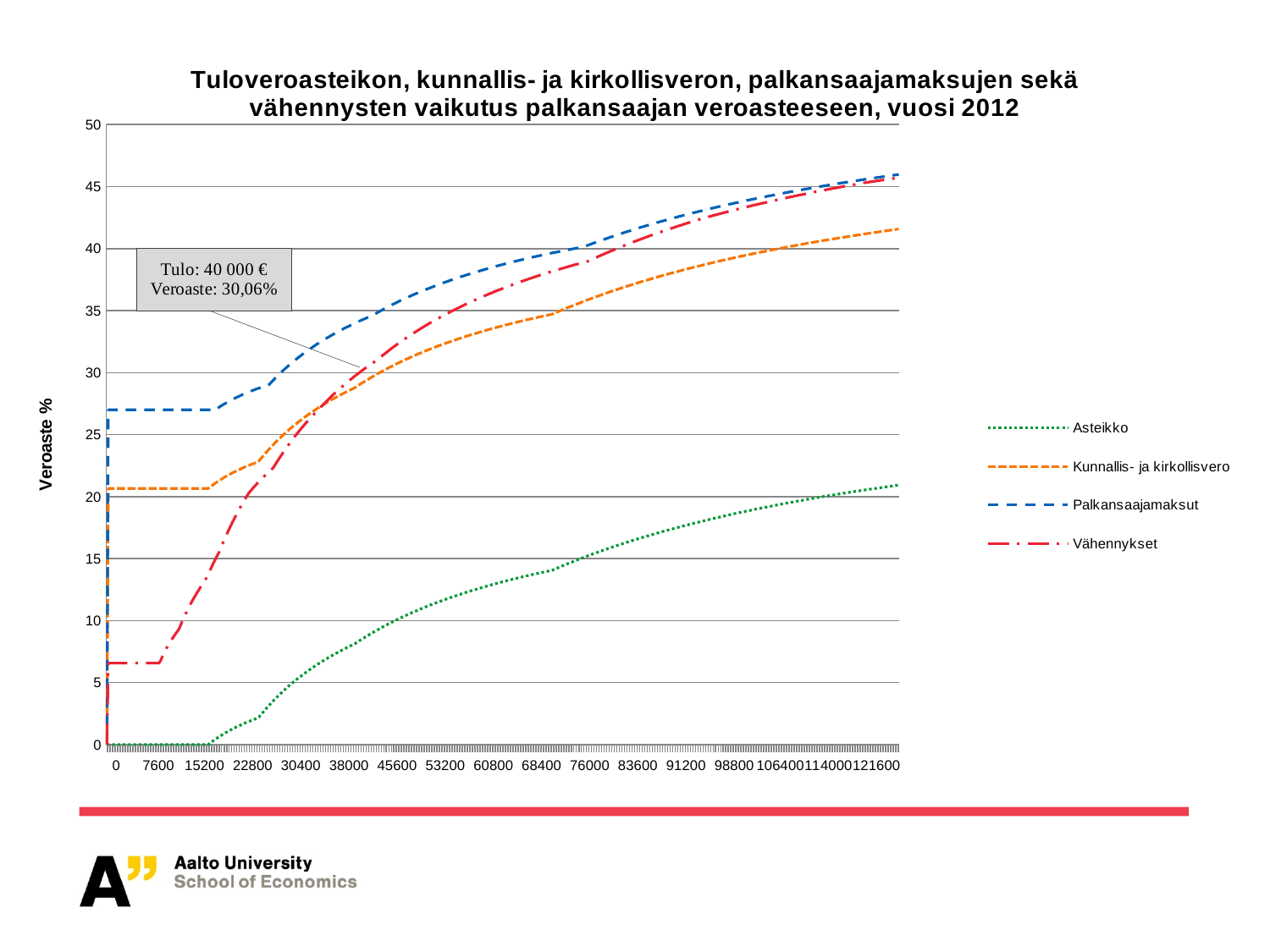
Does the Asteikko series rise or fall as income increases along the x axis? rise Is the value of Vähennykset at income 7600 greater or less than 10? less Which series has the lowest values across the whole income range? Asteikko At income 22800, which is higher: Palkansaajamaksut or Vähennykset? Palkansaajamaksut At income 121600, which is higher: Palkansaajamaksut or Kunnallis- ja kirkollisvero? Palkansaajamaksut According to the annotation, what is the tax rate (veroaste) at an income of 40 000 €? 30,06% Which series is drawn with the green dotted line? Asteikko What is the label of the vertical axis? Veroaste % What kind of chart is shown on the slide? line chart How many series does the legend list? 4 Is the value of Asteikko at income 60800 greater or less than 10? greater